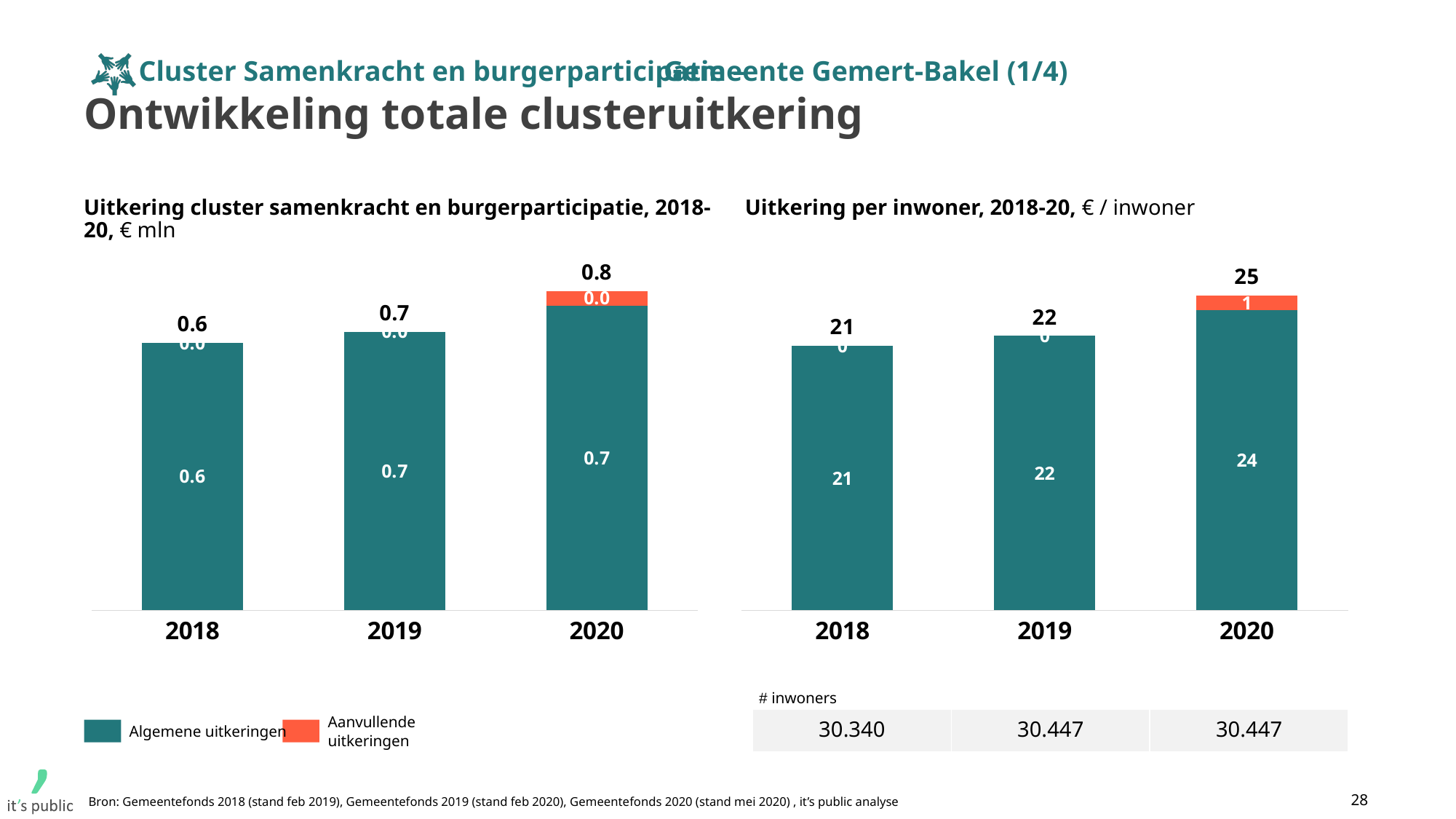
In the left chart (Uitkering cluster samenkracht en burgerparticipatie), do the totals rise or fall from 2018 to 2020? rise In the left chart (Uitkering cluster samenkracht en burgerparticipatie), which year has the highest total? 2020 In the right chart (Uitkering per inwoner), is the total for 2019 larger or smaller than the total for 2020? smaller What kind of chart is the left chart (Uitkering cluster samenkracht en burgerparticipatie)? stacked bar chart In the right chart (Uitkering per inwoner), what is the total shown above the bar for 2018? 21 In the right chart (Uitkering per inwoner), what is the value of Algemene uitkeringen for 2020? 24 In the right chart (Uitkering per inwoner), what is the difference between the totals for 2020 and 2018? 4 In the left chart (Uitkering cluster samenkracht en burgerparticipatie), what is the total value shown above the bar for 2020? 0.8 In the right chart (Uitkering per inwoner), which year has the lowest total? 2018 In the right chart (Uitkering per inwoner), what is the value of Aanvullende uitkeringen for 2020? 1 How many series does the legend list for the charts on this slide? 2 In the left chart (Uitkering cluster samenkracht en burgerparticipatie), what is the value of Algemene uitkeringen for 2019? 0.7